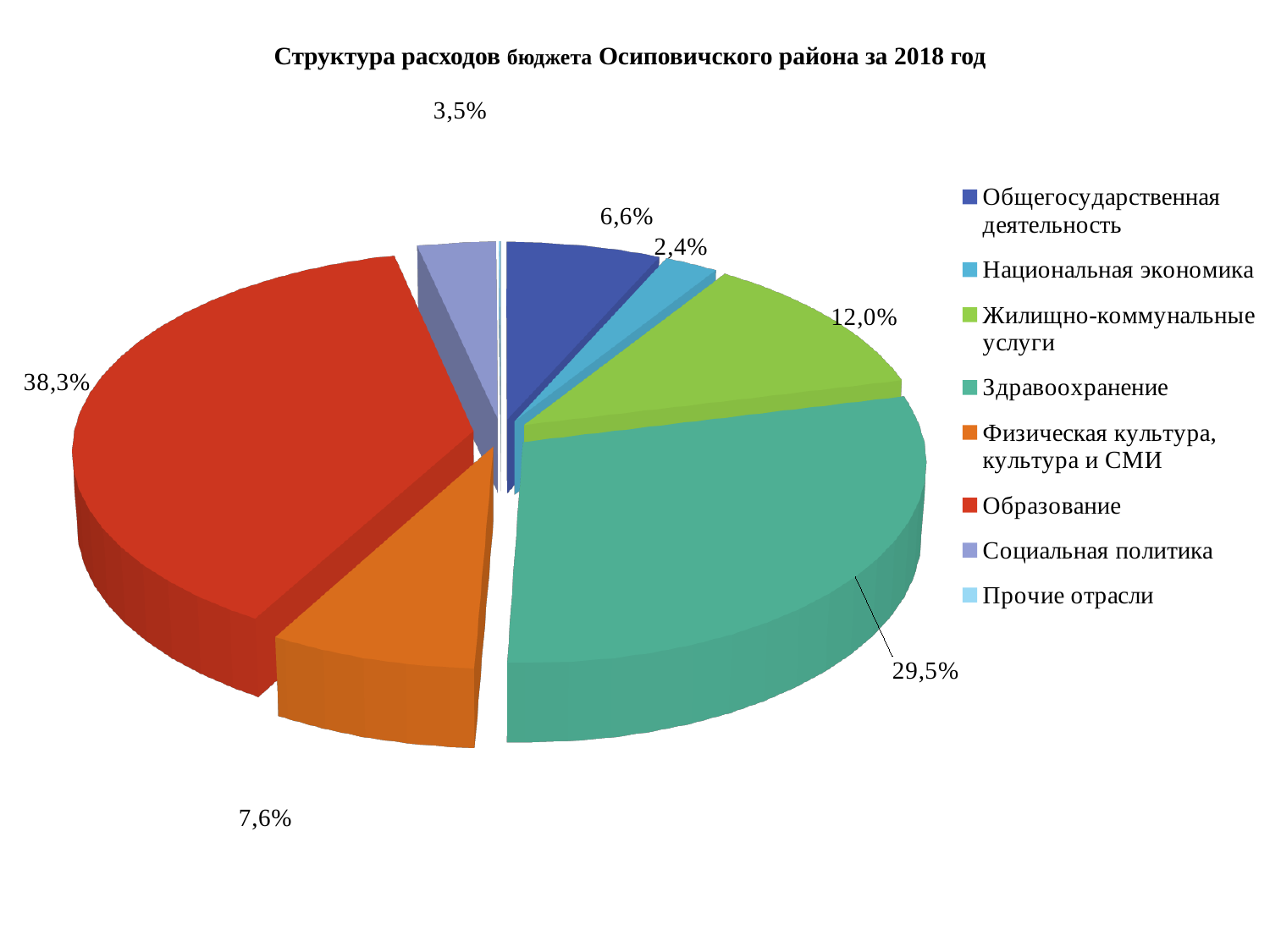
What kind of chart is shown on the slide? Pie chart Which category has the largest share of the pie? Образование What share of expenditure is labelled for Образование? 38,3% What share of expenditure is labelled for Социальная политика? 3,5% What share of expenditure is labelled for Жилищно-коммунальные услуги? 12,0% How many categories does the legend list? 8 What colour is the slice for Здравоохранение? Teal (green-blue) Which is larger, the share for Общегосударственная деятельность or the share for Физическая культура, культура и СМИ? Физическая культура, культура и СМИ What is the difference between the shares for Образование and Здравоохранение? 8,8% What share of expenditure is labelled for Здравоохранение? 29,5% What share of expenditure is labelled for Национальная экономика? 2,4% What is the title of the chart? Структура расходов бюджета Осиповичского района за 2018 год